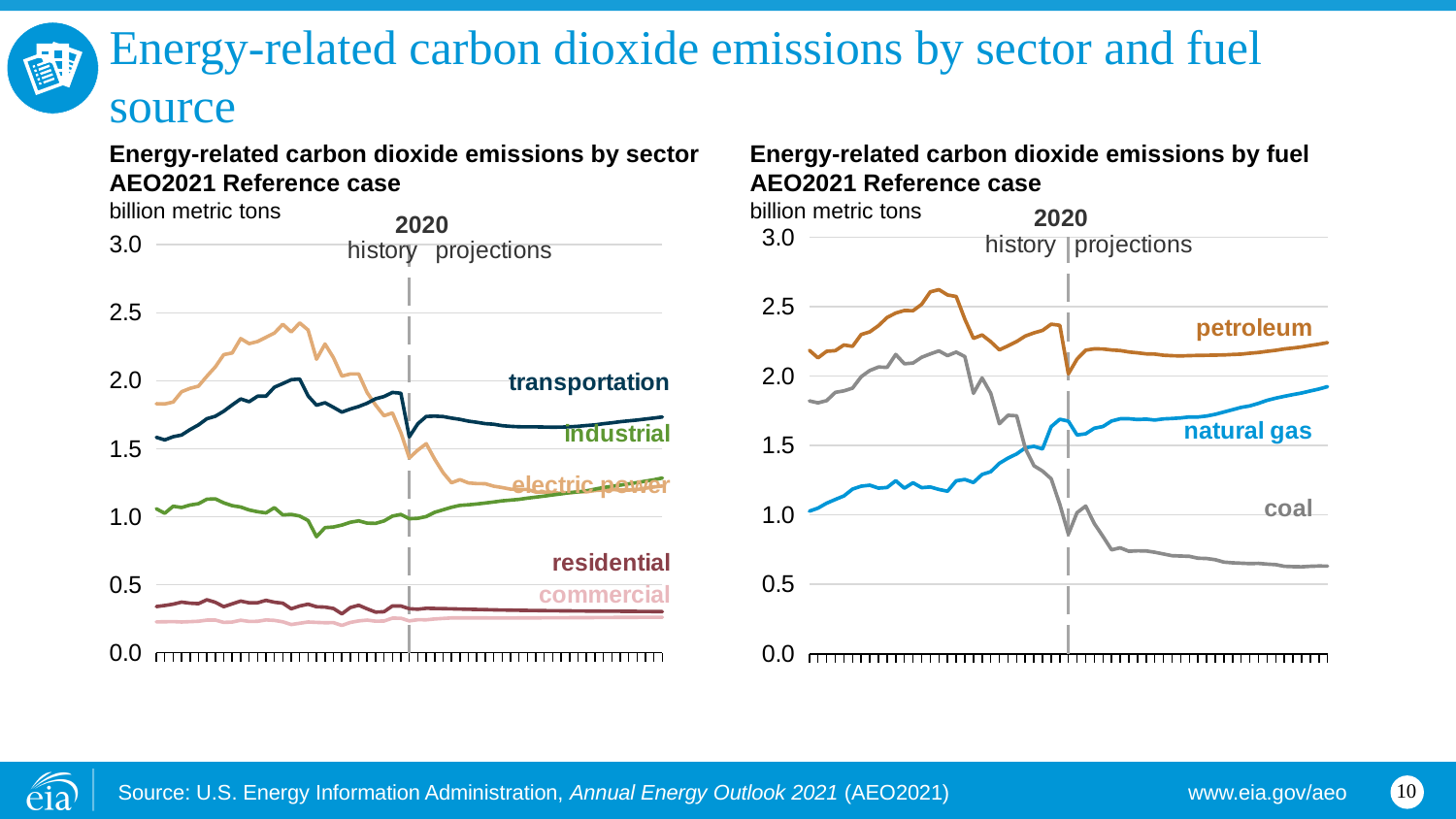
What type of chart is the 'Energy-related carbon dioxide emissions by sector' chart on the left? line chart How many sector series are labelled on the left chart, 'Energy-related carbon dioxide emissions by sector'? 5 In the right chart, 'Energy-related carbon dioxide emissions by fuel', do coal emissions rise or fall over the projection period? fall In the right chart, 'Energy-related carbon dioxide emissions by fuel', is the value for coal at the end of the projection period greater or less than 1.0? less In the right chart, 'Energy-related carbon dioxide emissions by fuel', is the value for petroleum at the end of the projection period greater or less than 2.0? greater In the right chart, 'Energy-related carbon dioxide emissions by fuel', do natural gas emissions rise or fall over the projection period? rise In the right chart, 'Energy-related carbon dioxide emissions by fuel', which fuel has the highest emissions at the end of the projection period? petroleum What unit is used on the y axis of both charts? billion metric tons In the left chart, 'Energy-related carbon dioxide emissions by sector', is the peak value for electric power greater or less than 2.0? greater How many fuel series are labelled on the right chart, 'Energy-related carbon dioxide emissions by fuel'? 3 In the right chart, 'Energy-related carbon dioxide emissions by fuel', which fuel has the lowest emissions at the end of the projection period? coal In the left chart, 'Energy-related carbon dioxide emissions by sector', which sector has the lowest emissions throughout the chart? commercial